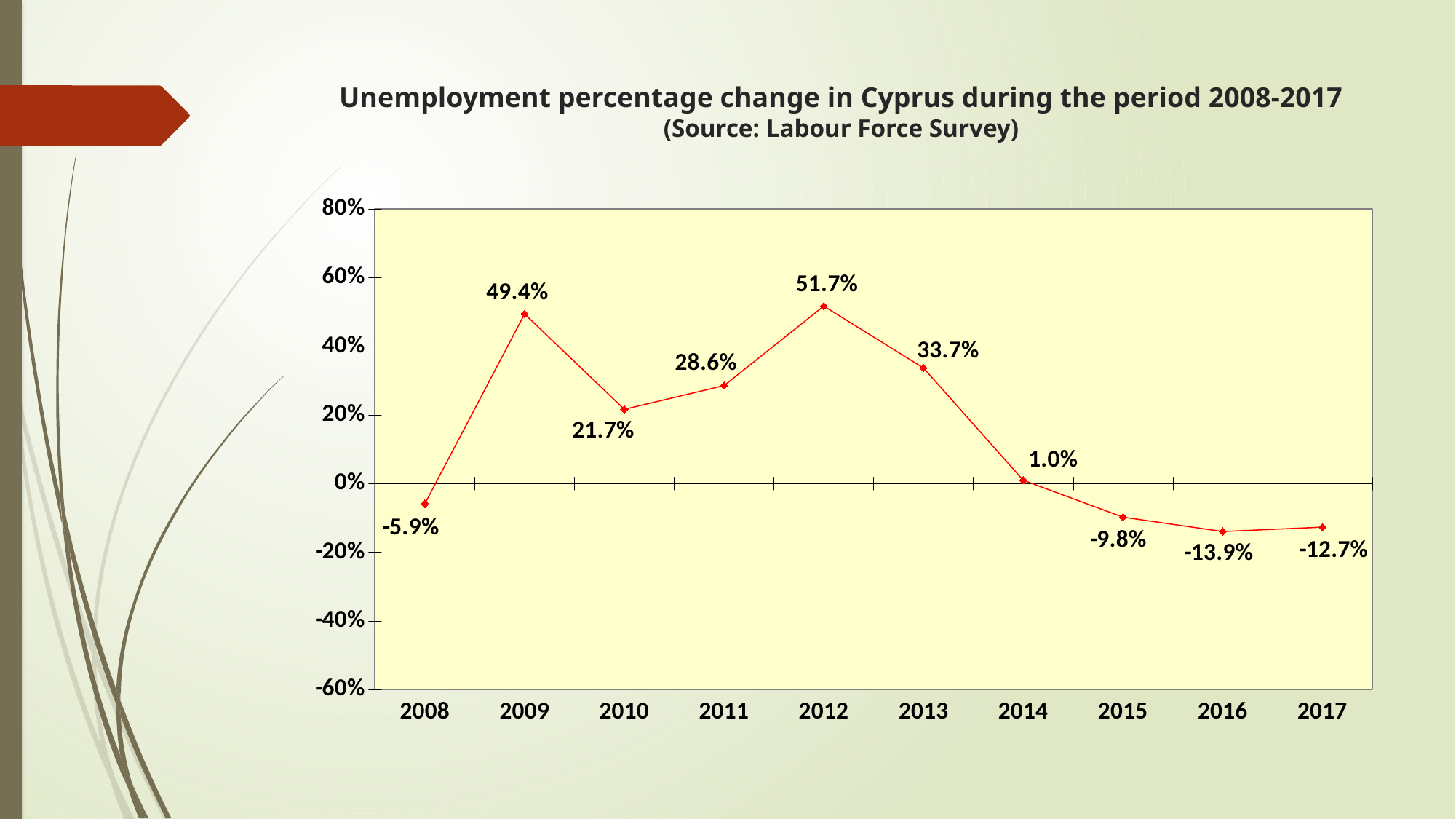
What is the unemployment percentage change in Cyprus for 2016? -13.9% How many years are plotted on the chart? 10 What is the difference between the values for 2012 and 2009? 2.3 percentage points Is the value for 2009 greater or less than 40%? greater What is the unemployment percentage change in Cyprus for 2012? 51.7% Which year has a larger value, 2011 or 2013? 2013 What kind of chart is shown on the slide? Line chart Do the values rise or fall from 2013 to 2016? Fall Which year has the highest unemployment percentage change? 2012 What is the unemployment percentage change in Cyprus for 2008? -5.9% Which year has the lowest unemployment percentage change? 2016 What source is cited in the chart title? Labour Force Survey